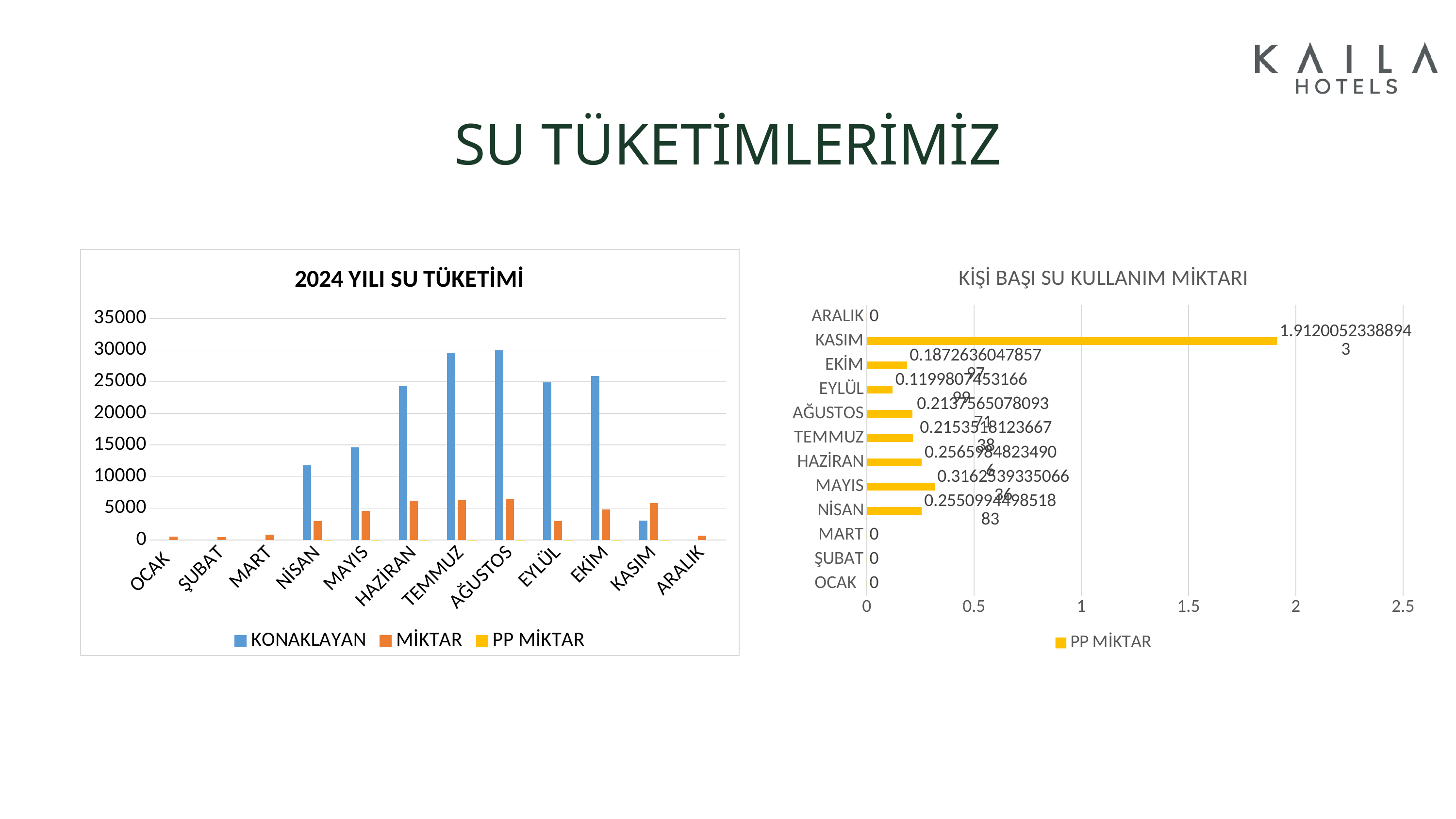
How many months are shown on the x axis of the '2024 YILI SU TÜKETİMİ' chart? 12 In the 'KİŞİ BAŞI SU KULLANIM MİKTARI' chart, which month has the highest PP MİKTAR value? KASIM In the 'KİŞİ BAŞI SU KULLANIM MİKTARI' chart, what is the PP MİKTAR value for MART? 0 In the '2024 YILI SU TÜKETİMİ' chart, which is larger, the KONAKLAYAN value for MAYIS or for HAZİRAN? HAZİRAN In the 'KİŞİ BAŞI SU KULLANIM MİKTARI' chart, which is larger, the value for MAYIS or for NİSAN? MAYIS In the '2024 YILI SU TÜKETİMİ' chart, is the KONAKLAYAN value for NİSAN greater or less than 10000? greater In the '2024 YILI SU TÜKETİMİ' chart, is the KONAKLAYAN value for KASIM greater or less than 5000? less In the 'KİŞİ BAŞI SU KULLANIM MİKTARI' chart, what is the PP MİKTAR value for KASIM? 1.91200523388943 How many series does the legend of the '2024 YILI SU TÜKETİMİ' chart list? 3 What kind of chart is the '2024 YILI SU TÜKETİMİ' chart? bar chart What series name is shown in the legend of the 'KİŞİ BAŞI SU KULLANIM MİKTARI' chart? PP MİKTAR In the '2024 YILI SU TÜKETİMİ' chart, is the KONAKLAYAN value for AĞUSTOS greater or less than 25000? greater